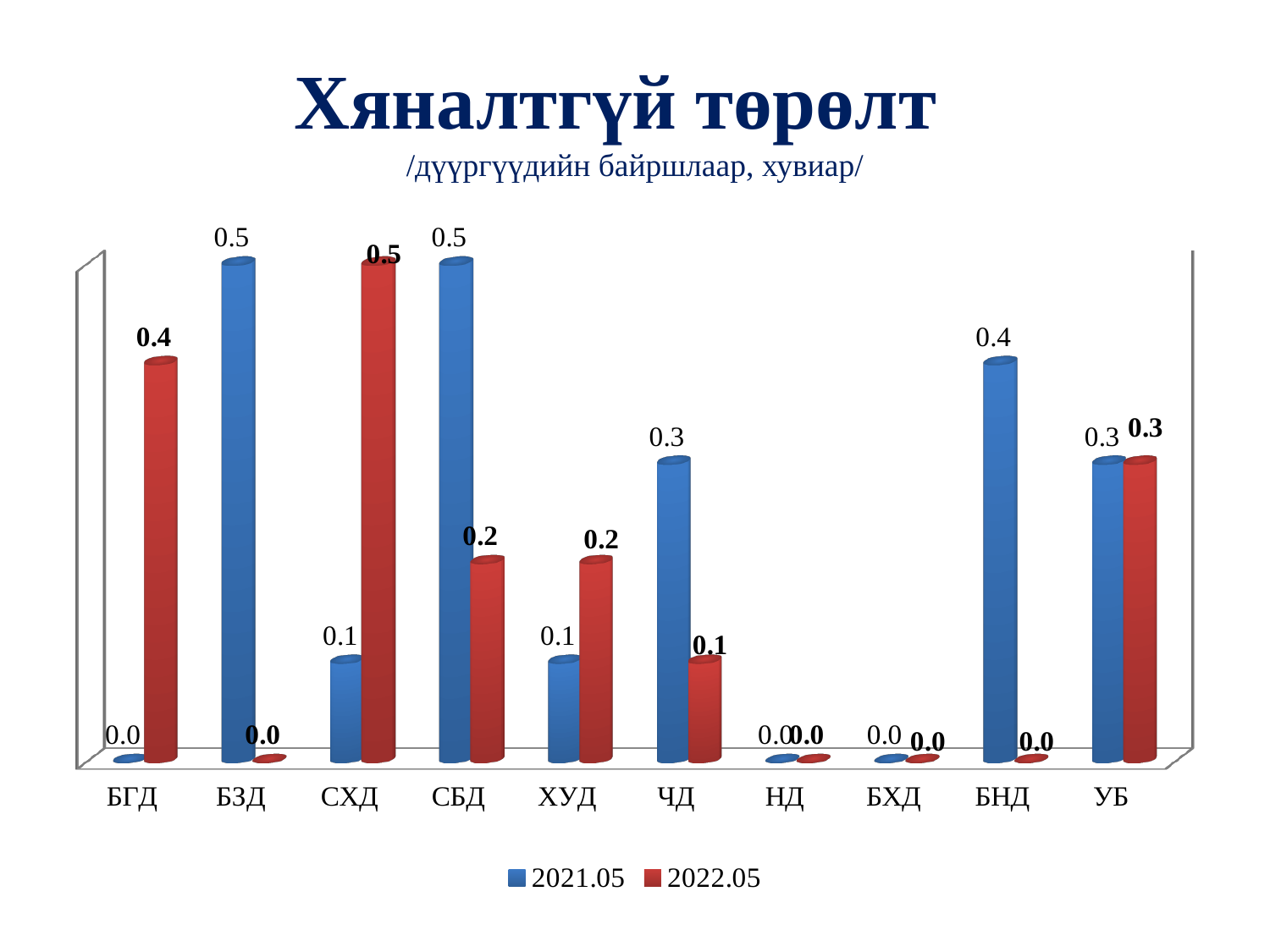
What is the difference between the 2022.05 and 2021.05 values for СХД? 0.4 How many series does the legend list? 2 How many categories are shown on the x axis? 10 Which category has the highest value in the 2022.05 series? СХД What kind of chart is shown on the slide? Bar chart What is the value for БНД in the 2021.05 series? 0.4 Which is larger for ХУД: the 2021.05 value or the 2022.05 value? 2022.05 What is the difference between the 2021.05 and 2022.05 values for СБД? 0.3 What is the value for СХД in the 2021.05 series? 0.1 What is the value for ЧД in the 2022.05 series? 0.1 Which is larger for ЧД: the 2021.05 value or the 2022.05 value? 2021.05 What is the value for БГД in the 2022.05 series? 0.4